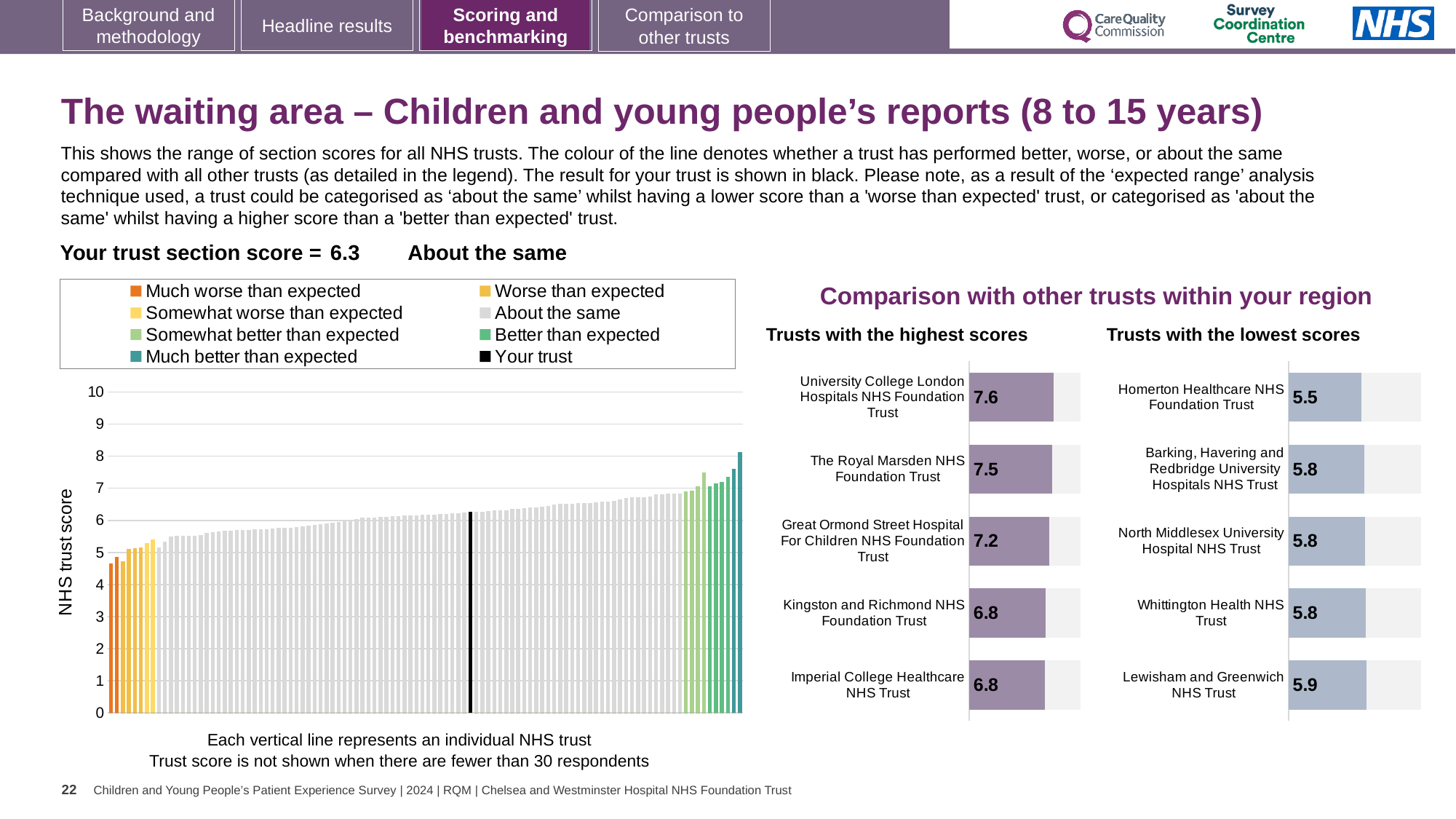
In the 'Trusts with the lowest scores' chart, what is the difference between the scores of Lewisham and Greenwich NHS Trust and Homerton Healthcare NHS Foundation Trust? 0.4 In the 'Trusts with the highest scores' chart, how many trusts are listed? 5 In the 'Trusts with the highest scores' chart, which trust has the highest score? University College London Hospitals NHS Foundation Trust In the 'Trusts with the lowest scores' chart, what is the score for Homerton Healthcare NHS Foundation Trust? 5.5 In the 'Trusts with the highest scores' chart, what is the score for University College London Hospitals NHS Foundation Trust? 7.6 In the large chart on the left, do the trust scores rise or fall from left to right? Rise What kind of chart is the large chart on the left showing NHS trust scores? Bar chart In the 'Trusts with the highest scores' chart, what is the difference between the scores of University College London Hospitals NHS Foundation Trust and Great Ormond Street Hospital For Children NHS Foundation Trust? 0.4 In the 'Trusts with the highest scores' chart, what is the score for Great Ormond Street Hospital For Children NHS Foundation Trust? 7.2 In the 'Trusts with the lowest scores' chart, which has the larger score: Homerton Healthcare NHS Foundation Trust or Lewisham and Greenwich NHS Trust? Lewisham and Greenwich NHS Trust In the 'Trusts with the lowest scores' chart, which trust has the lowest score? Homerton Healthcare NHS Foundation Trust How many entries does the legend of the large chart on the left list? 8